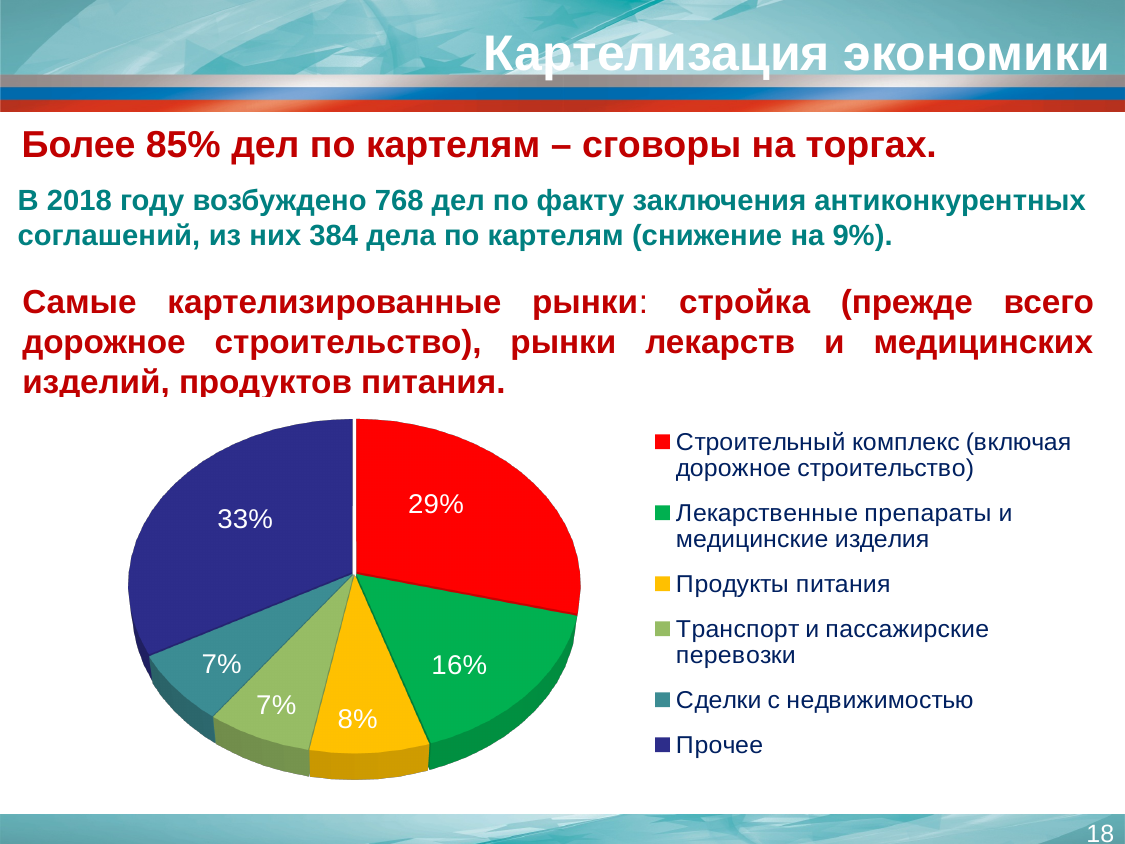
What share of the pie does Строительный комплекс (включая дорожное строительство) have? 29% Which is larger: the share of Продукты питания or the share of Транспорт и пассажирские перевозки? Продукты питания What kind of chart is shown on the slide? pie chart What share of the pie does Прочее have? 33% What share of the pie does Лекарственные препараты и медицинские изделия have? 16% How many entries does the legend list? 6 Which category has the largest slice of the pie? Прочее What share of the pie does Сделки с недвижимостью have? 7% What is the difference between the shares of Строительный комплекс and Лекарственные препараты и медицинские изделия? 13% What colour is the slice for Прочее? dark blue How many slices does the pie chart have? 6 What share of the pie does Продукты питания have? 8%